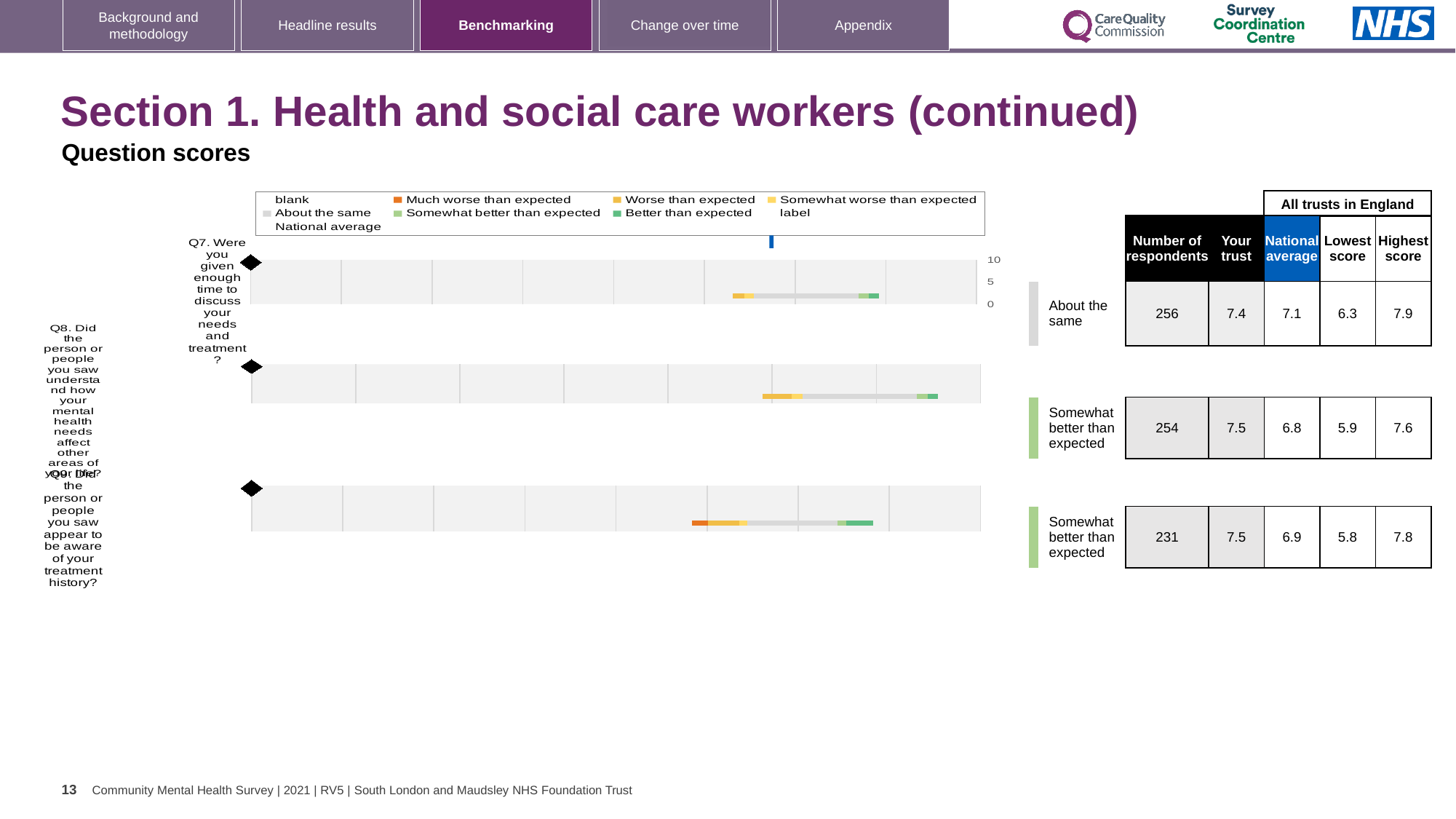
For Q7, what is the national average score? 7.1 For Q8, what is the lowest score among all trusts in England? 5.9 For Q7, how much higher is the 'Your trust' score than the national average? 0.3 For Q7 (Were you given enough time to discuss your needs and treatment?), what is the 'Your trust' score? 7.4 What benchmark category is shown for Q9? Somewhat better than expected How many respondents answered Q8 (Did the person or people you saw understand how your mental health needs affect other areas of your life?)? 254 For Q9 (Did the person or people you saw appear to be aware of your treatment history?), what is the highest score among all trusts in England? 7.8 How many questions (Q7, Q8, Q9) are plotted on the slide? 3 What kind of chart is used to show the question scores on this slide? bar chart Which question has the fewest respondents? Q9 For Q8, which is larger: the 'Your trust' score or the national average? Your trust (7.5) What benchmark category is shown for Q7? About the same